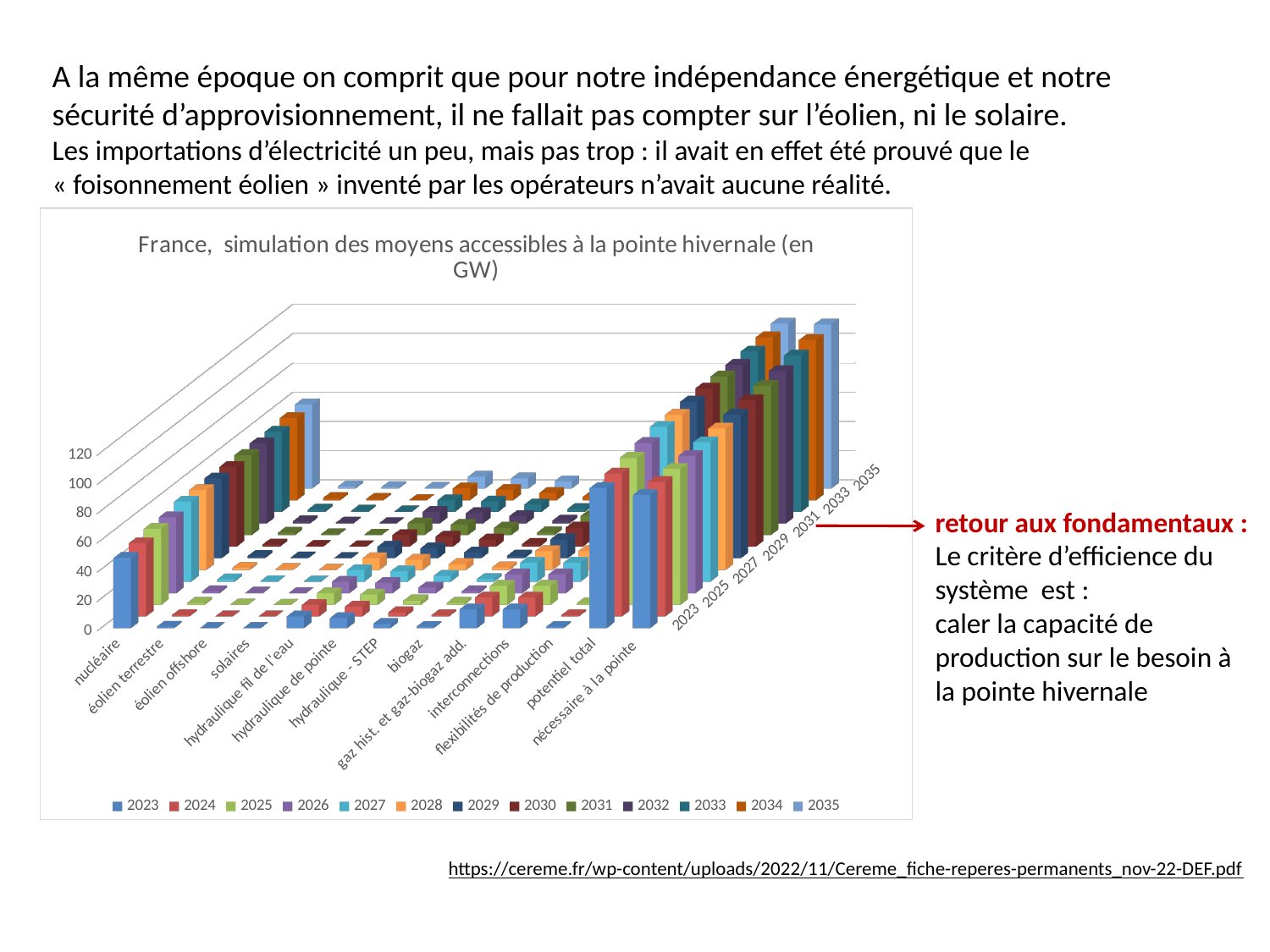
Do the values for potentiel total rise or fall from 2023 to 2035? rise Is the value for éolien terrestre in 2023 greater or less than 20? less In what unit are the values of the chart expressed, according to its title? GW Is the value for nucléaire in 2023 greater or less than 20? greater Which is larger in 2023: nucléaire or solaires? nucléaire Which is larger in 2023: potentiel total or éolien terrestre? potentiel total How many series does the chart legend list? 13 Do the values for nécessaire à la pointe rise or fall from 2023 to 2035? rise What kind of chart is shown on the slide? bar chart What is the title of the chart? France, simulation des moyens accessibles à la pointe hivernale (en GW) How many categories are shown along the x axis of the chart? 13 Is the value for potentiel total in 2023 greater or less than 60? greater